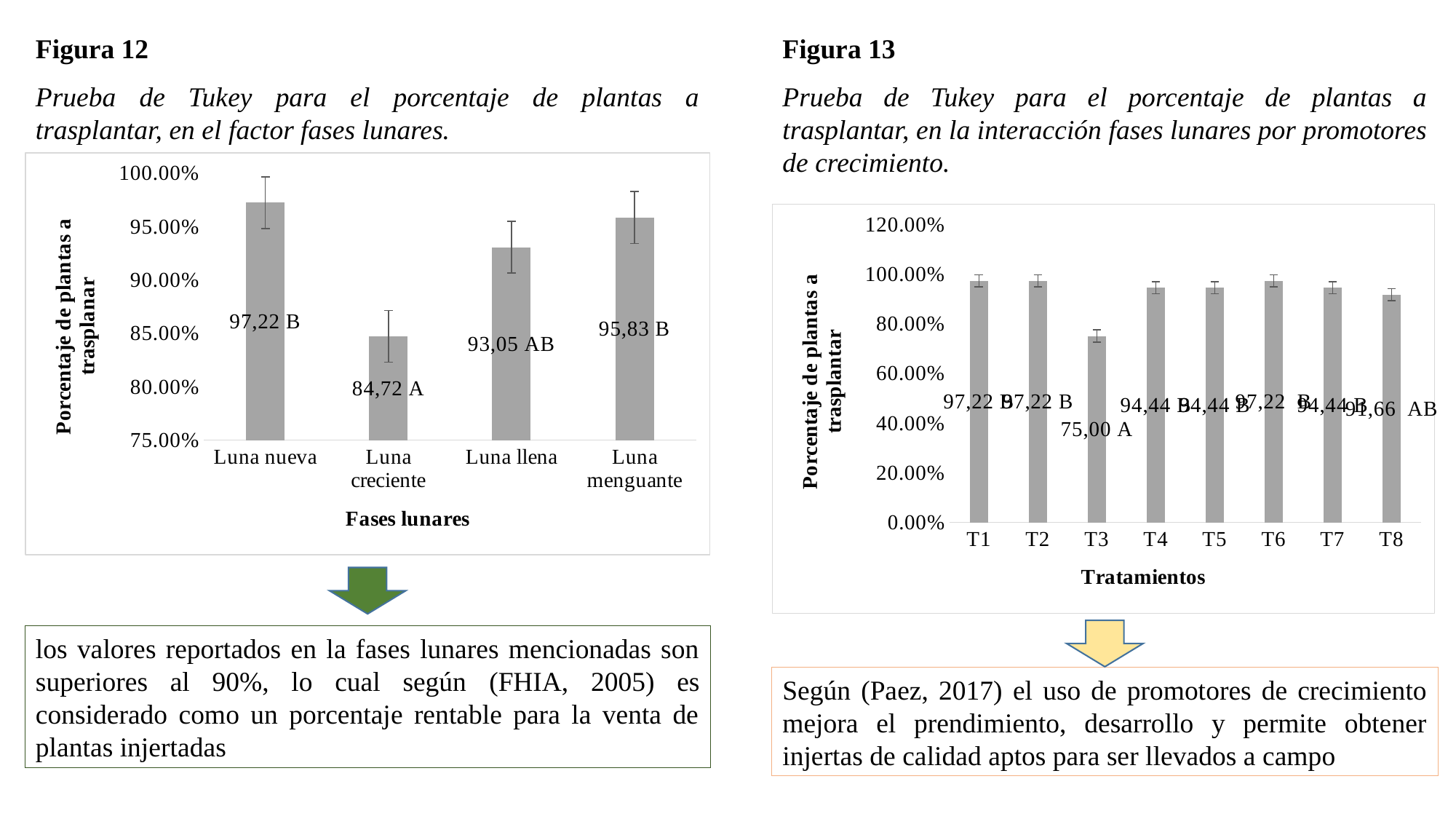
In Figura 13, how many treatments are plotted on the x axis? 8 In Figura 12, how many lunar phases are plotted? 4 In Figura 13, what is the value shown for T8? 91,66 AB In Figura 12, what is the value shown for Luna nueva? 97,22 B In Figura 12, what is the difference between the values for Luna nueva and Luna creciente? 12,50 In Figura 13, what is the value shown for T3? 75,00 A What kind of chart is Figura 13? Bar chart In Figura 12, which lunar phase has the lowest percentage of plants to transplant? Luna creciente In Figura 12, what is the value shown for Luna creciente? 84,72 A In Figura 13, which treatment has the lowest percentage of plants to transplant? T3 In Figura 12, which lunar phase has the highest percentage of plants to transplant? Luna nueva In Figura 12, is the value for Luna llena greater or less than 90.00%? greater